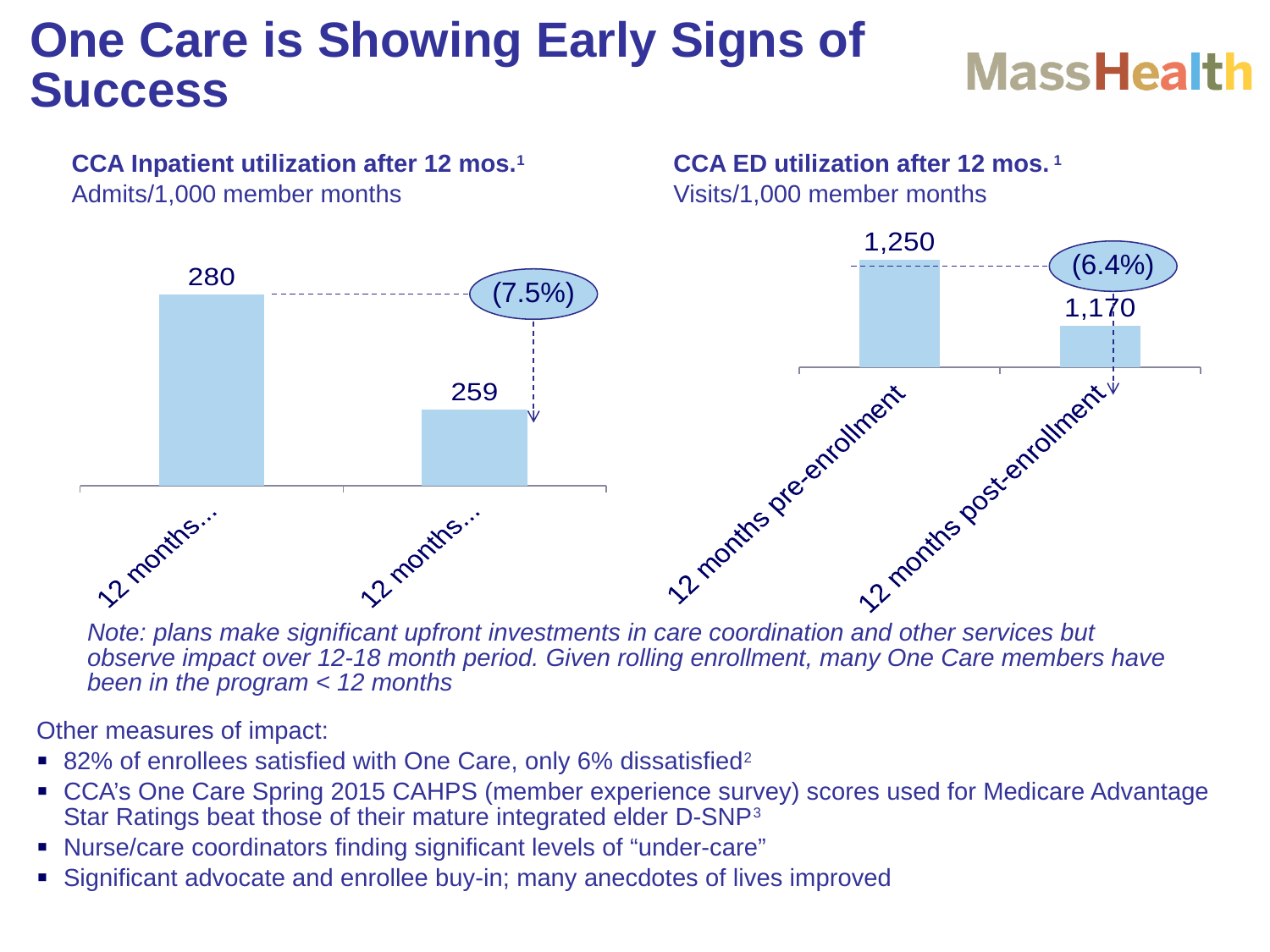
What type of chart is the CCA Inpatient utilization chart? bar chart What percentage change is shown in the callout on the CCA ED utilization chart? (6.4%) In the CCA ED utilization chart, which category has the higher value? 12 months pre-enrollment How many bars are in the CCA ED utilization chart? 2 In the CCA Inpatient utilization chart, what is the difference between the two bars? 21 In the CCA Inpatient utilization chart, what is the value of the right bar? 259 In the CCA Inpatient utilization chart, what is the value of the left bar? 280 In the CCA Inpatient utilization chart, is the left bar or the right bar larger? left bar In the CCA ED utilization chart, what is the difference between the pre-enrollment and post-enrollment values? 80 In the CCA ED utilization chart, what is the value for 12 months post-enrollment? 1,170 In the CCA ED utilization chart, what is the value for 12 months pre-enrollment? 1,250 In the CCA ED utilization chart, do the values rise or fall from pre-enrollment to post-enrollment? fall